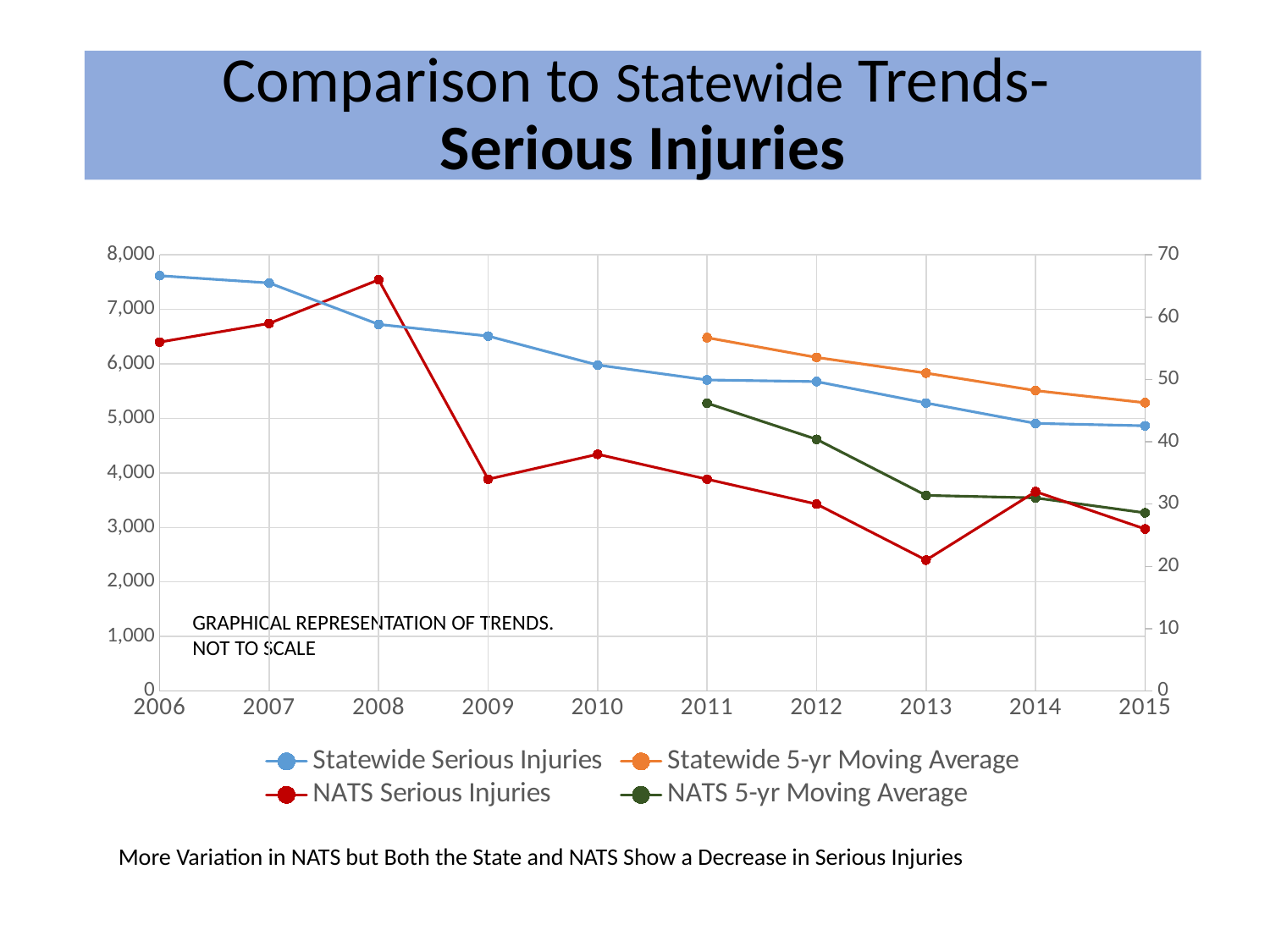
In which year is the NATS Serious Injuries value lowest? 2013 Is the Statewide Serious Injuries value for 2012 greater or less than 6,000? less How many years are shown along the x axis? 10 Is the Statewide Serious Injuries value for 2006 greater or less than 7,000? greater In which year is the Statewide Serious Injuries value highest? 2006 In which year is the NATS Serious Injuries value highest? 2008 What kind of chart is shown on the slide? Line chart What is the title of the slide containing the chart? Comparison to Statewide Trends- Serious Injuries How many series does the legend list? 4 Is the NATS Serious Injuries value for 2013 greater or less than 30 on the right axis? less Do the Statewide Serious Injuries values generally rise or fall from 2006 to 2015? fall Which is larger, the NATS Serious Injuries value for 2008 or for 2009? 2008